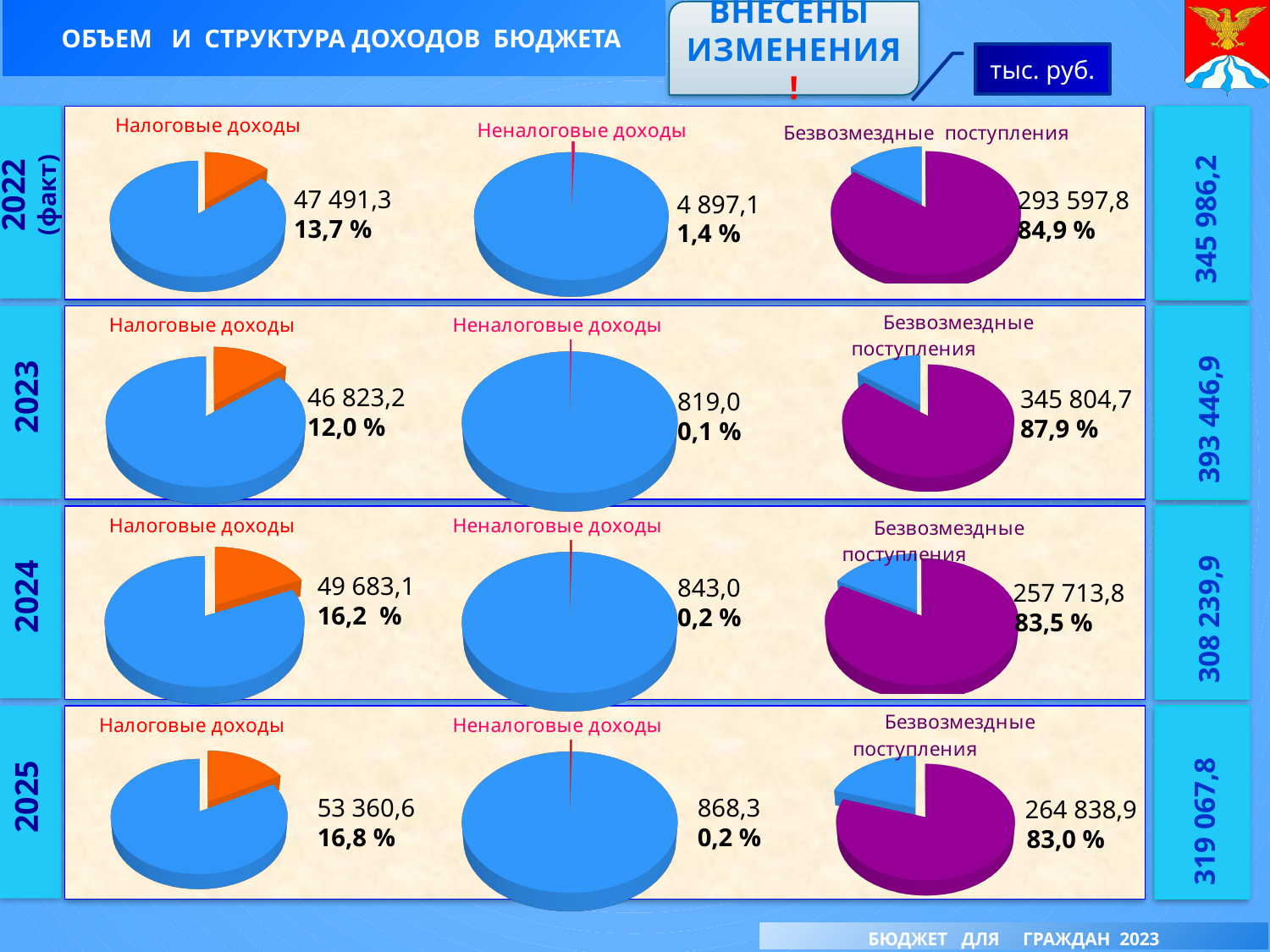
In the 2022 (факт) row, what share does the Безвозмездные поступления pie chart show for that category? 84,9 % How many pie charts are shown on the slide? 12 What total is shown at the right of the 2024 row? 308 239,9 What is the difference between the Безвозмездные поступления value in the 2023 row and in the 2022 (факт) row? 52 206,9 What type of chart is used throughout the slide? Pie chart In the 2022 (факт) row, what value is shown on the Налоговые доходы pie chart? 47 491,3 Which is larger: the Налоговые доходы value in the 2024 row or the Налоговые доходы value in the 2025 row? 2025 row (53 360,6) In the 2023 row, what percentage is shown on the Налоговые доходы pie chart? 12,0 % In the 2025 row, what value is shown on the Неналоговые доходы pie chart? 868,3 In the 2025 row, what percentage is shown on the Налоговые доходы pie chart? 16,8 % In the 2023 row, what value is shown on the Неналоговые доходы pie chart? 819,0 In the 2024 row, what value is shown on the Безвозмездные поступления pie chart? 257 713,8